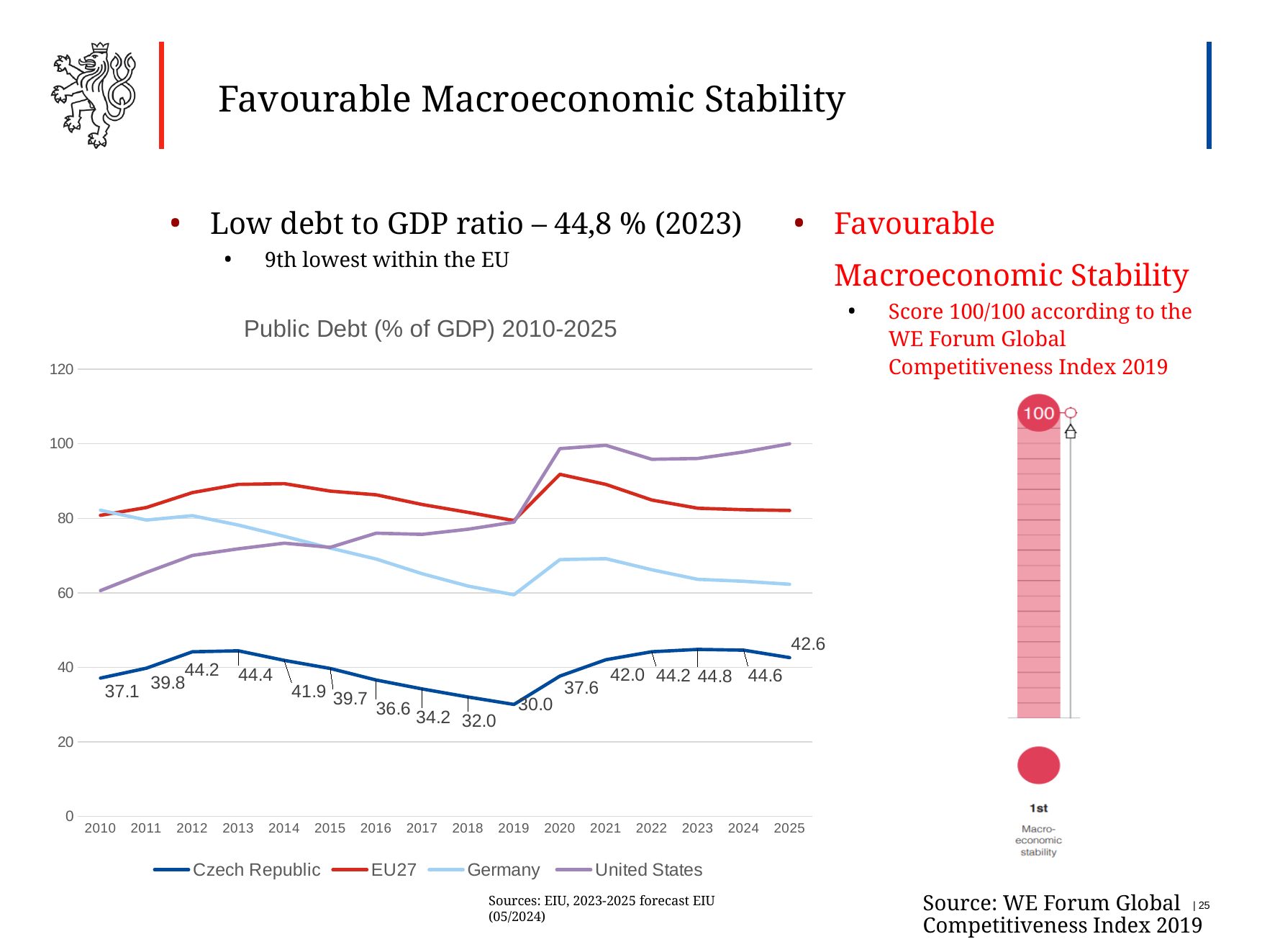
In which year is the Czech Republic's public debt lowest? 2019 In which year is the Czech Republic's public debt highest? 2023 What is the public debt value for the Czech Republic in 2019? 30.0 How many years are shown on the x axis of the chart? 16 Which series has the highest public debt in 2025? United States How many series does the chart legend list? 4 What is the difference between the Czech Republic's public debt in 2023 and in 2019? 14.8 What is the public debt value for the Czech Republic in 2023? 44.8 What is the title of the chart? Public Debt (% of GDP) 2010-2025 What kind of chart is shown on the slide? Line chart Which is larger in 2010, the value for Germany or the value for the United States? Germany